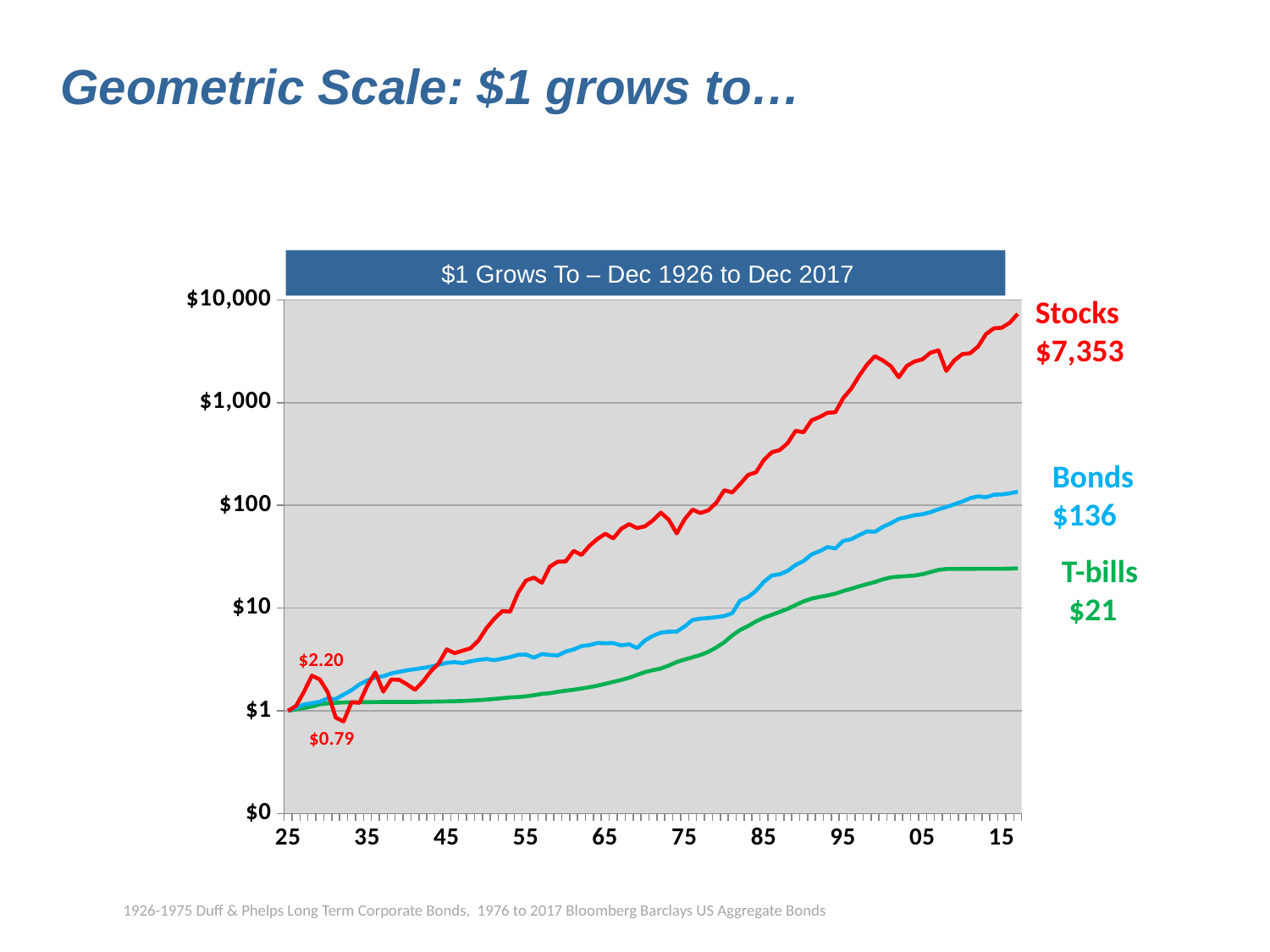
Which asset class has the highest ending value on the chart? Stocks What is the difference between the ending values of Bonds and T-bills? $115 What does $1 invested in Bonds grow to by Dec 2017 according to the chart? $136 What is the low value labeled on the Stocks line in the early 1930s? $0.79 What is the title shown in the banner above the chart? $1 Grows To – Dec 1926 to Dec 2017 Which asset class has the lowest ending value on the chart? T-bills Which has a larger ending value, Bonds or T-bills? Bonds What type of chart is shown on the slide? Line chart What does $1 invested in Stocks grow to by Dec 2017 according to the chart? $7,353 What does $1 invested in T-bills grow to by Dec 2017 according to the chart? $21 How many series are plotted on the chart? 3 What is the early peak value labeled on the Stocks line near the late 1920s? $2.20